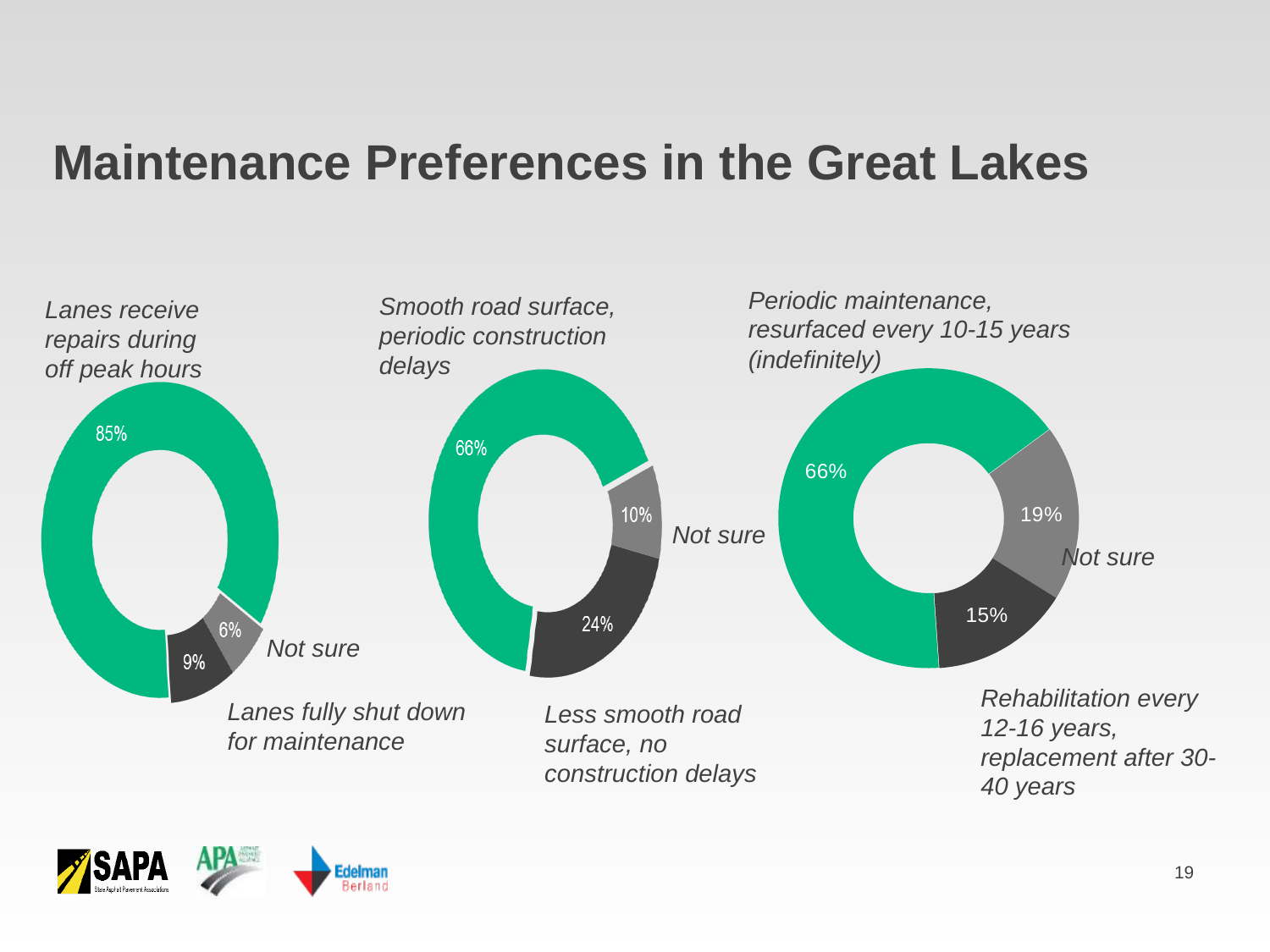
In the right donut chart, what share of respondents answered 'Not sure'? 19% In the left donut chart, what share of respondents prefer lanes fully shut down for maintenance? 9% In the middle donut chart, what share of respondents prefer a less smooth road surface with no construction delays? 24% How many donut charts are shown on the slide? 3 In the middle donut chart, what share of respondents prefer a smooth road surface with periodic construction delays? 66% In the right donut chart, what share of respondents prefer rehabilitation every 12-16 years with replacement after 30-40 years? 15% In the middle donut chart, what is the difference in percentage points between the 'Smooth road surface, periodic construction delays' share and the 'Less smooth road surface, no construction delays' share? 42 percentage points In the right donut chart, which option has the smallest share? Rehabilitation every 12-16 years, replacement after 30-40 years In the right donut chart, which is larger: the 'Not sure' share or the 'Rehabilitation every 12-16 years' share? Not sure In the left donut chart, which option has the largest share? Lanes receive repairs during off peak hours In the left donut chart, what share of respondents answered 'Not sure'? 6% In the left donut chart, what share of respondents prefer lanes receiving repairs during off peak hours? 85%